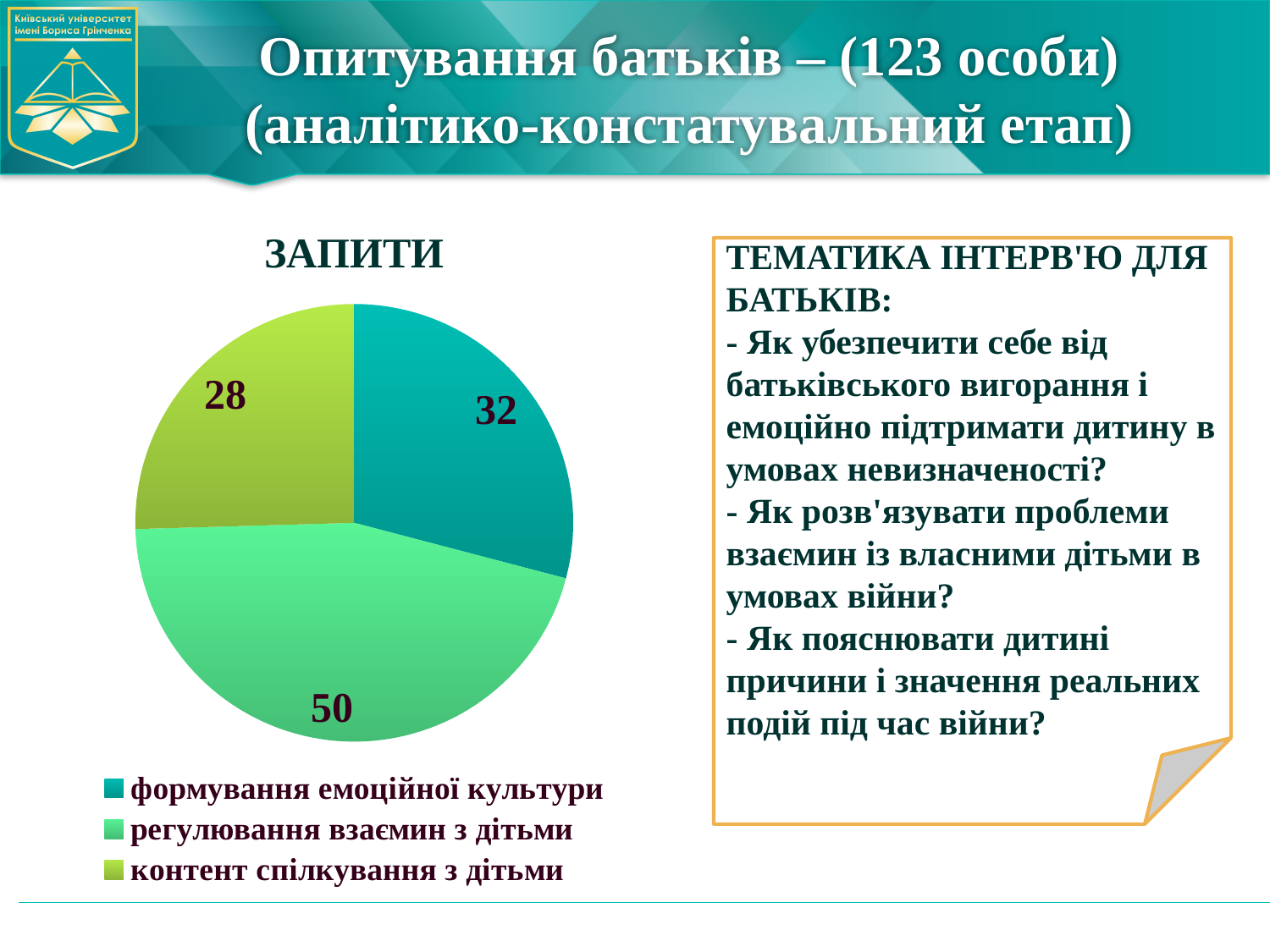
What is the title of the pie chart? ЗАПИТИ What is the value for "формування емоційної культури" in the pie chart? 32 What is the total of all three values in the pie chart? 110 What is the difference between the values for "регулювання взаємин з дітьми" and "формування емоційної культури"? 18 What is the value for "контент спілкування з дітьми" in the pie chart? 28 Which category has the largest slice in the pie chart? регулювання взаємин з дітьми How many slices does the pie chart have? 3 What type of chart is shown under the title "ЗАПИТИ"? pie chart What is the value for "регулювання взаємин з дітьми" in the pie chart? 50 What is the difference between the values for "формування емоційної культури" and "контент спілкування з дітьми"? 4 Which category has the smallest slice in the pie chart? контент спілкування з дітьми Which is larger: the value for "формування емоційної культури" or for "контент спілкування з дітьми"? формування емоційної культури